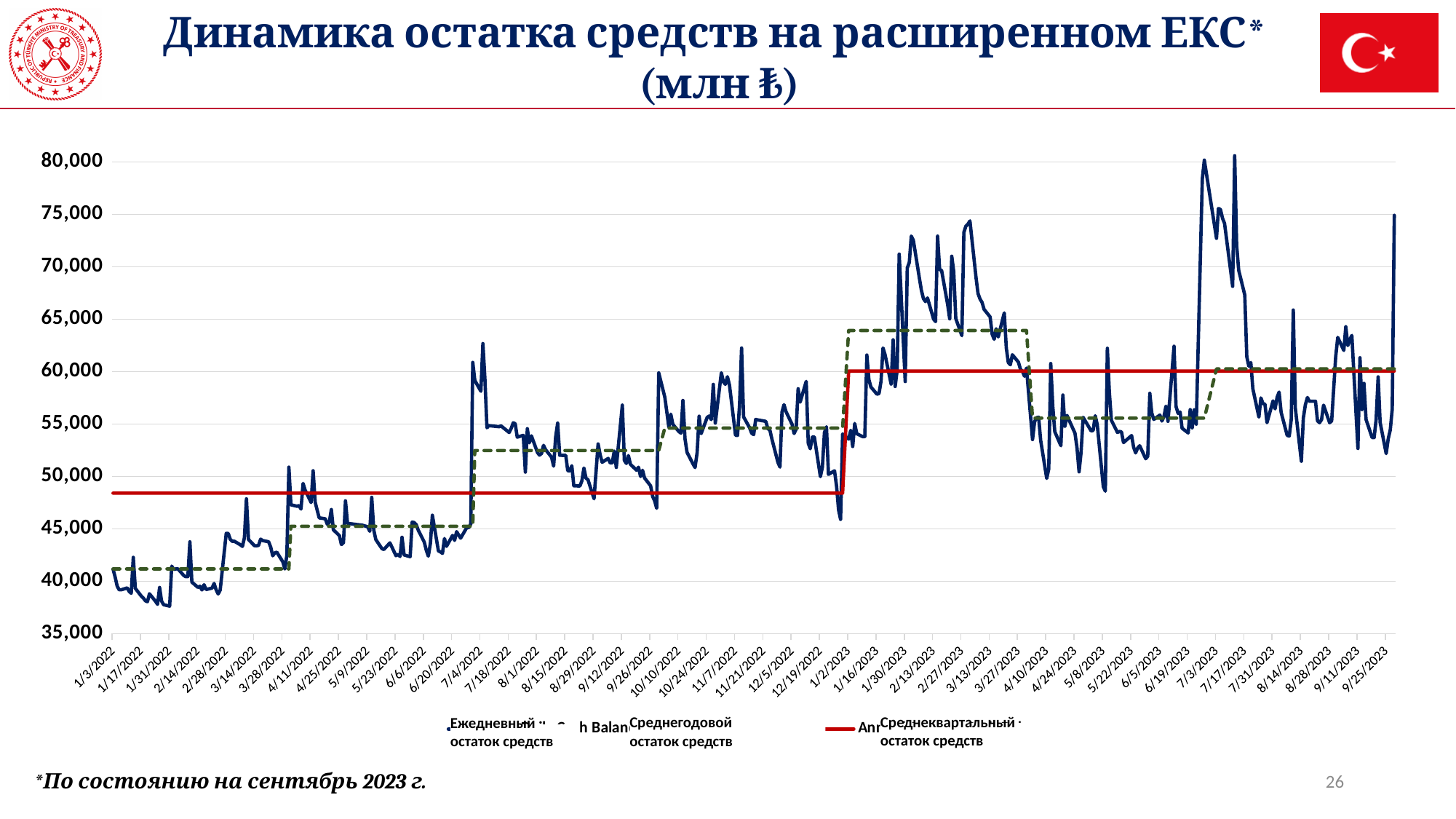
Is the red solid line after 1/2/2023 greater or less than 55,000? greater Is the red solid line during 2022 greater or less than 50,000? less How many series does the chart's legend list? 3 Is the green dashed line in the first quarter of 2023 greater or less than 60,000? greater Which is larger: the daily balance at the start of the chart (1/3/2022) or at the end (9/25/2023)? 9/25/2023 What is the title of the chart on the slide? Динамика остатка средств на расширенном ЕКС* (млн ₺) Overall, does the dark blue daily balance line rise or fall from the start of 2022 to September 2023? rise What kind of chart is shown on the slide? line chart